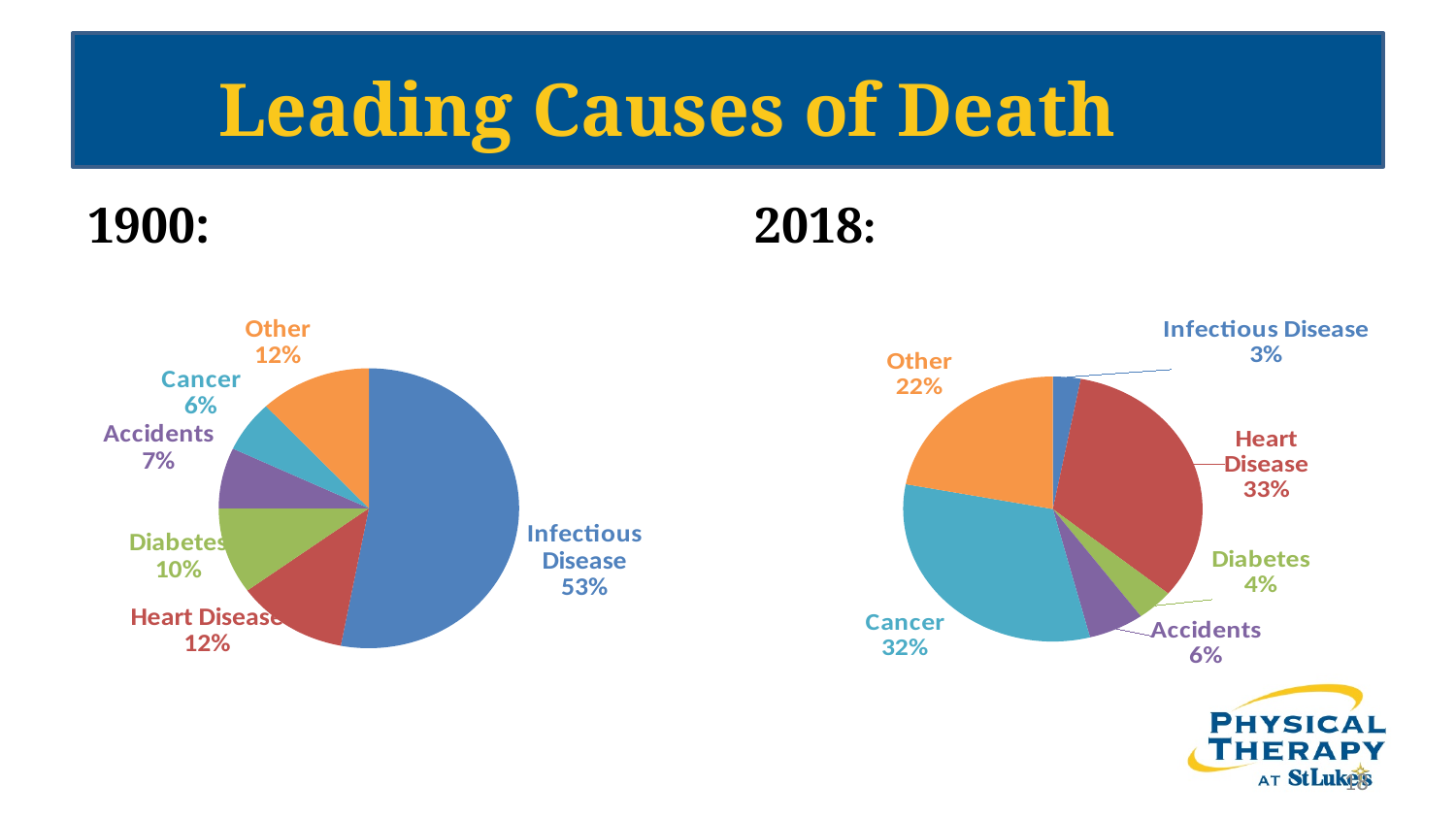
In the 1900 pie chart, which cause of death has the largest share? Infectious Disease In the 1900 pie chart, which cause of death has the smallest share? Cancer In the 2018 pie chart, which cause of death has the smallest share? Infectious Disease In the 2018 pie chart, what colour is the Cancer slice? Teal In the 2018 pie chart, what is the difference between the Other share and the Diabetes share? 18% In the 1900 pie chart, what is the difference between the Infectious Disease share and the Heart Disease share? 41% How many slices does the 2018 pie chart have? 6 In the 1900 pie chart, what share of deaths is attributed to Infectious Disease? 53% What type of chart is used to show the 1900 leading causes of death? Pie chart In the 1900 pie chart, which is larger: the share for Diabetes or the share for Accidents? Diabetes In the 2018 pie chart, what share of deaths is attributed to Cancer? 32% In the 2018 pie chart, what share of deaths is attributed to Heart Disease? 33%